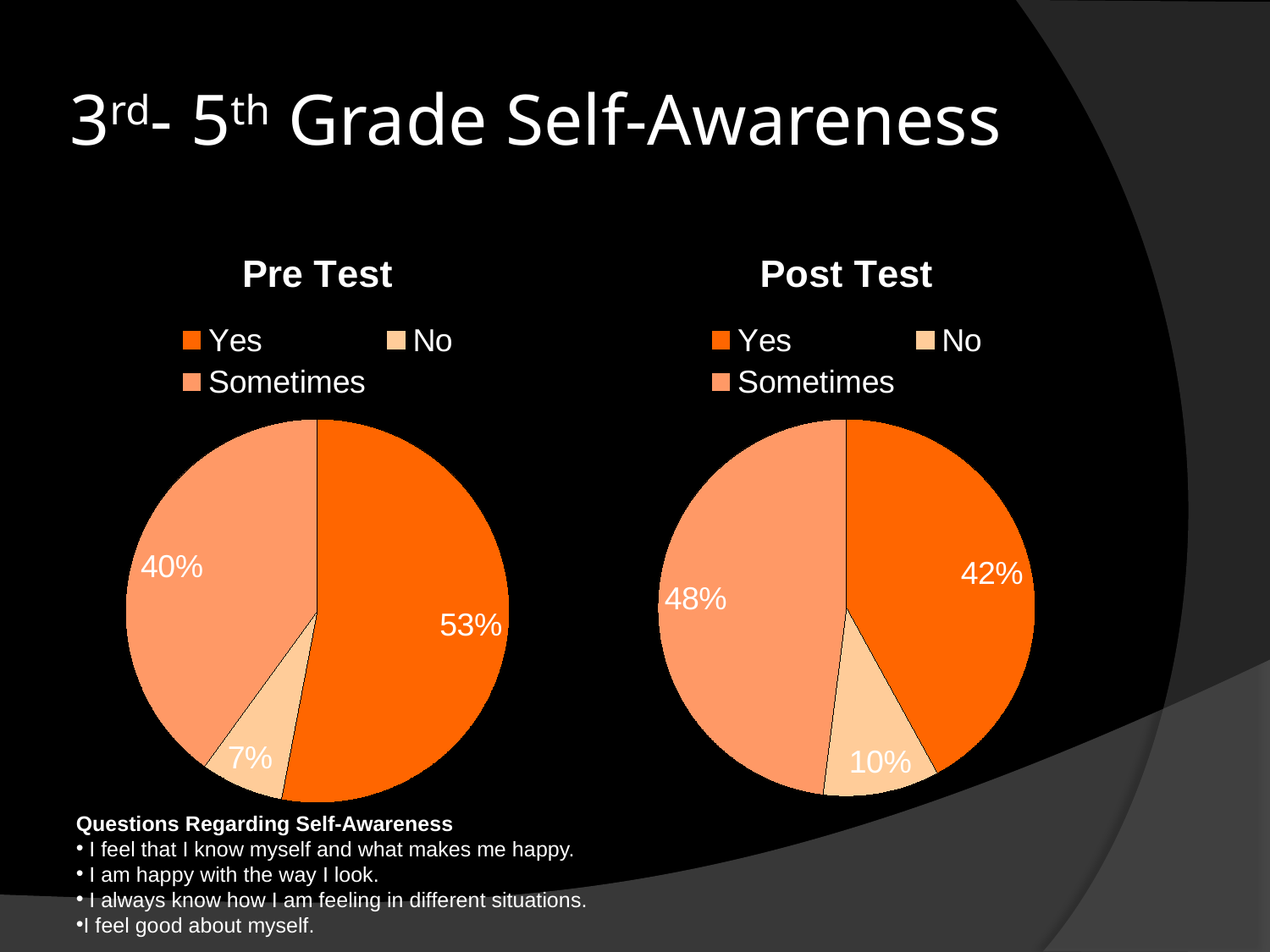
In the Post Test chart, what percentage of responses were No? 10% In the Pre Test chart, what is the difference between the Yes and Sometimes shares? 13% Is the No share larger in the Pre Test chart or the Post Test chart? Post Test How many slices does the Post Test pie chart have? 3 What are the three legend entries in the Pre Test chart? Yes, No, Sometimes What type of chart is the Pre Test chart? Pie chart In the Post Test chart, which response has the largest share? Sometimes In the Pre Test chart, which response has the smallest share? No In the Pre Test chart, what percentage of responses were Yes? 53% In the Post Test chart, what percentage of responses were Sometimes? 48% In the Pre Test chart, what percentage of responses were No? 7% What is the difference between the Yes share in the Pre Test chart and the Yes share in the Post Test chart? 11%